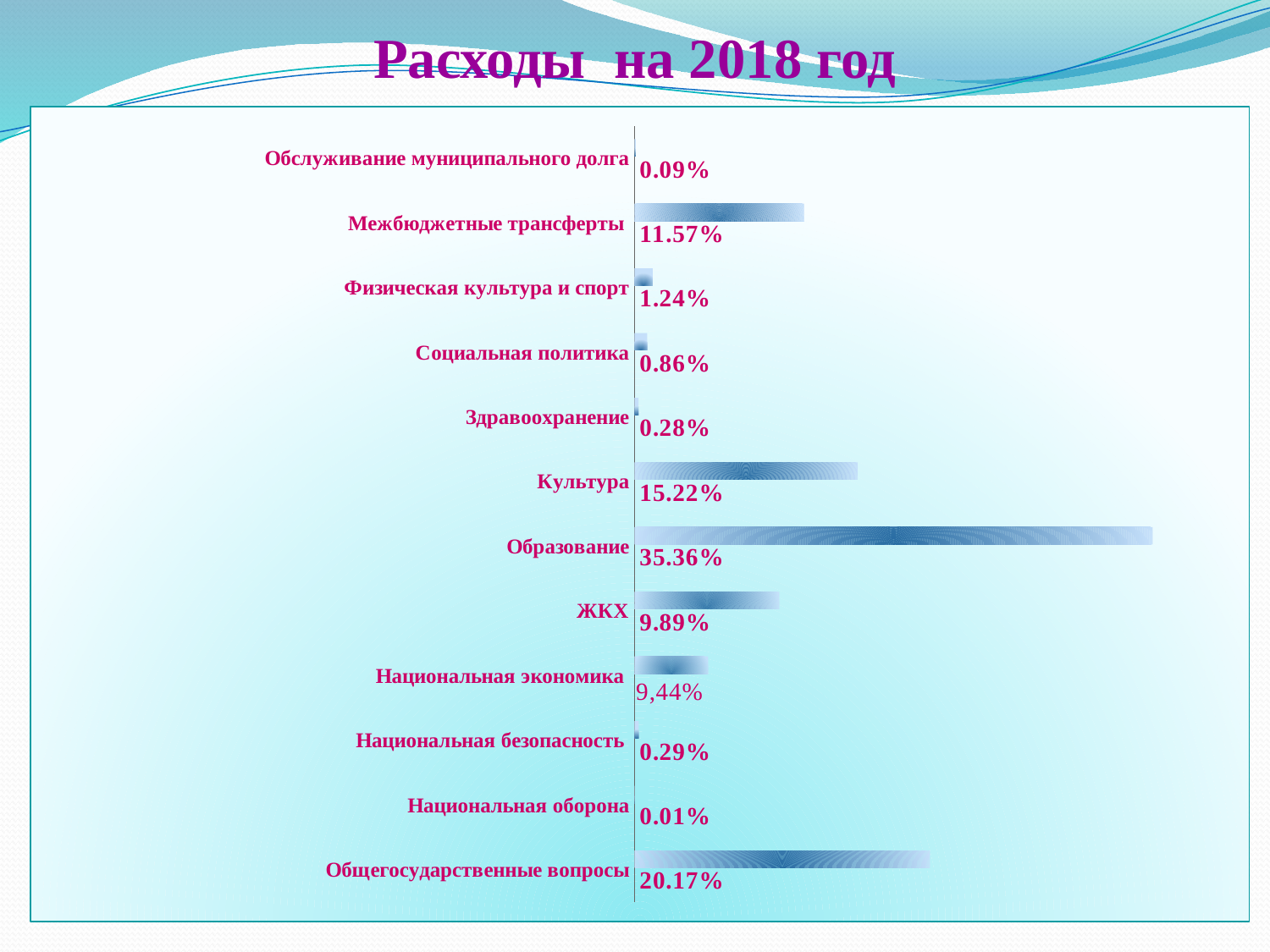
How many categories are shown in the chart? 12 What is the value for Образование? 35.36% What type of chart is shown on the slide? Bar chart What is the value for Общегосударственные вопросы? 20.17% Which is larger, the value for Культура or the value for Межбюджетные трансферты? Культура What is the value for Национальная экономика? 9,44% What is the difference between the values for Образование and Культура? 20.14% What is the value for Межбюджетные трансферты? 11.57% What is the difference between the values for Общегосударственные вопросы and Культура? 4.95% Which category has the highest value? Образование What is the title of the chart? Расходы на 2018 год Which category has the lowest value? Национальная оборона